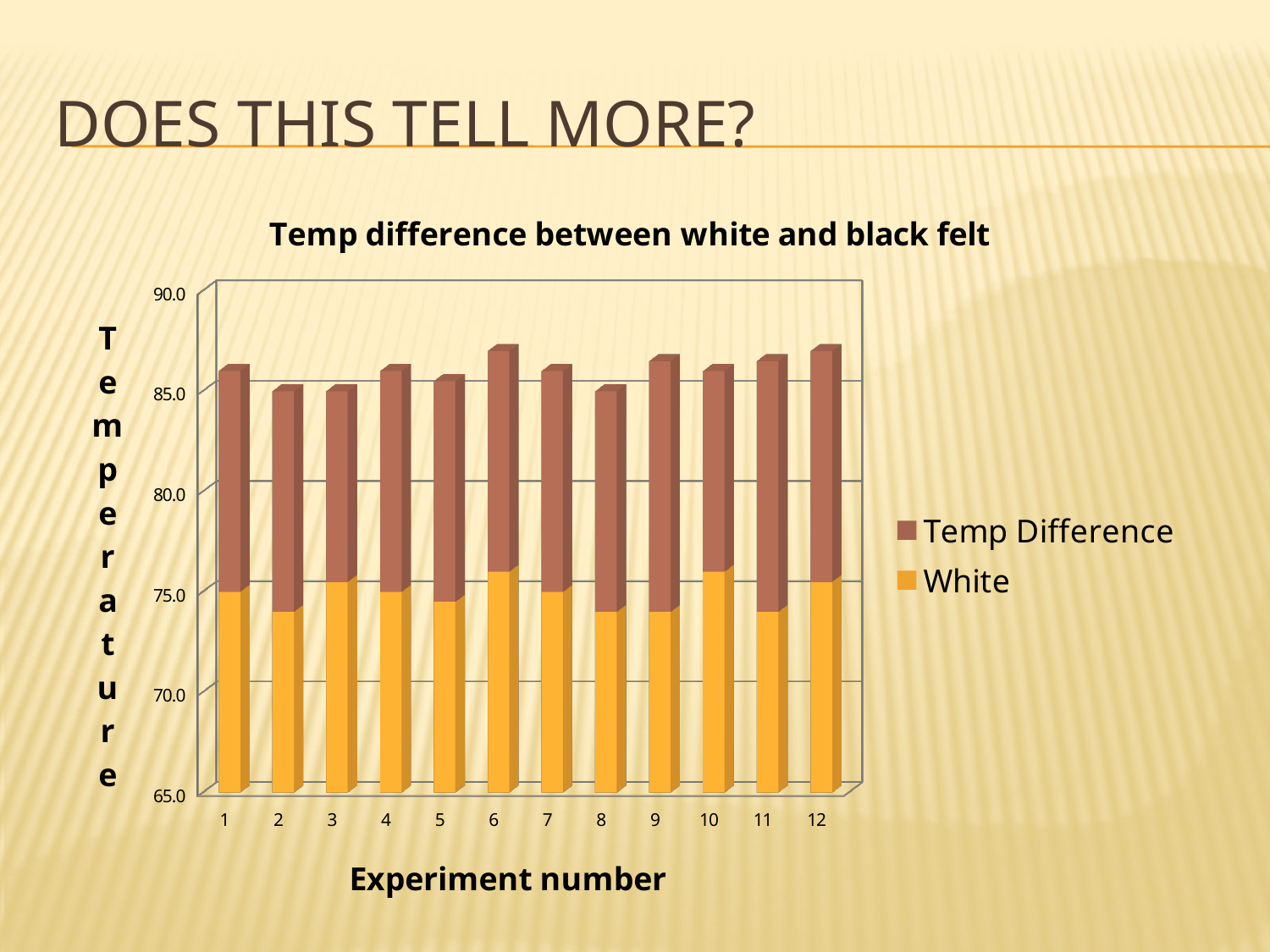
Is the White value for experiment 6 greater or less than 75.0? greater Is the total height of the stacked bar for experiment 3 greater or less than 80.0? greater Which has the taller stacked bar overall, experiment 6 or experiment 2? experiment 6 Which has the larger White value, experiment 6 or experiment 8? experiment 6 Is the total height of the stacked bar for experiment 6 greater or less than 90.0? less What is the title of the chart? Temp difference between white and black felt What kind of chart is shown on the slide? bar chart How many experiments (categories) are shown on the x axis? 12 What is the label of the x axis? Experiment number How many series does the legend list? 2